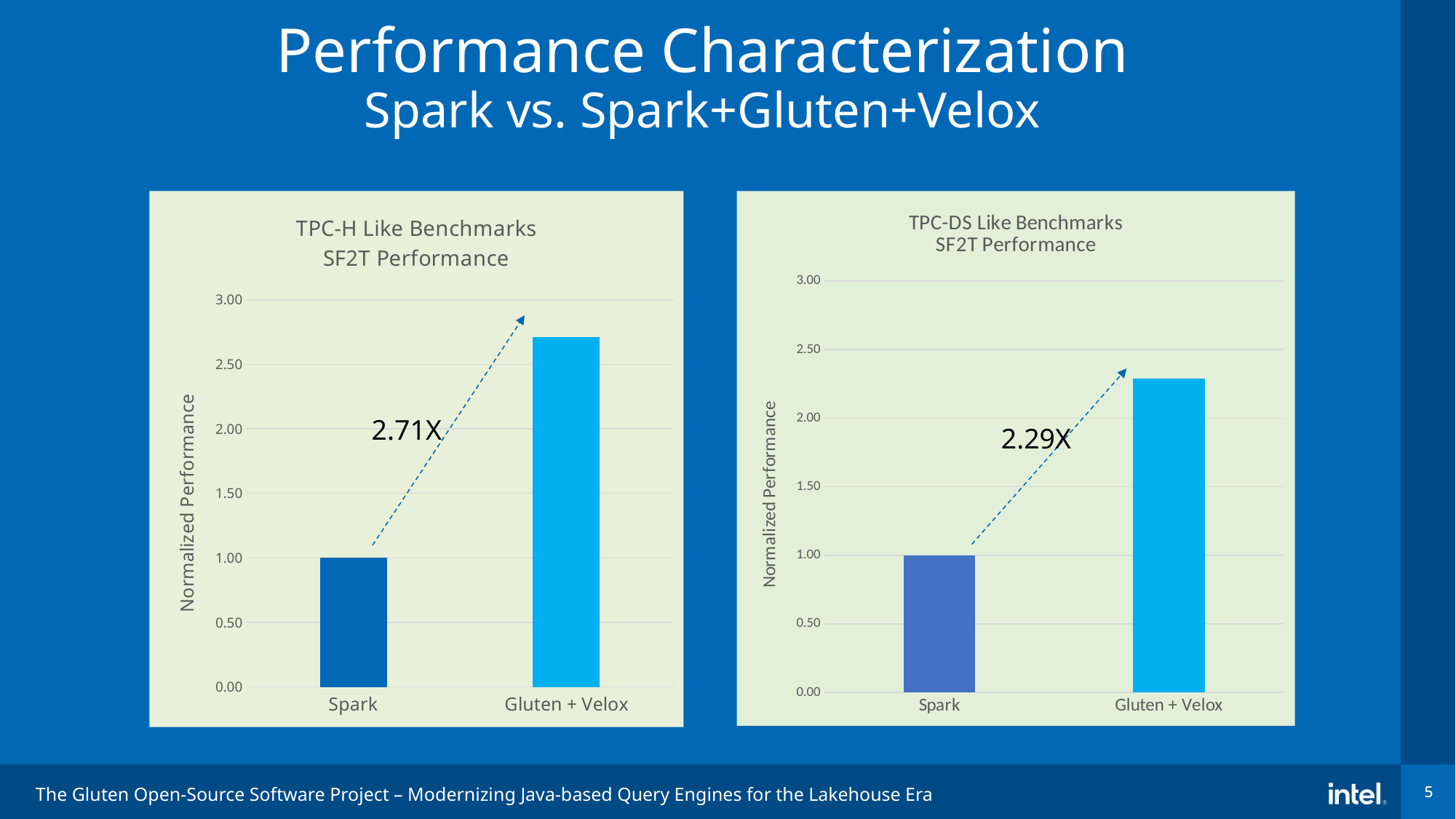
How many categories are shown in the TPC-H Like Benchmarks chart? 2 In the TPC-DS Like Benchmarks chart, is the value for Gluten + Velox greater or less than 2.50? less In the TPC-H Like Benchmarks chart, is the value for Gluten + Velox greater or less than 2.50? greater In the TPC-H Like Benchmarks chart, what is the normalized performance value for Spark? 1.00 In the TPC-DS Like Benchmarks chart, what speedup factor is annotated next to the arrow? 2.29X In the TPC-DS Like Benchmarks chart, what is the normalized performance value for Spark? 1.00 What type of chart is the TPC-DS Like Benchmarks chart? Bar chart In the TPC-H Like Benchmarks chart, which category has the highest normalized performance? Gluten + Velox In the TPC-DS Like Benchmarks chart, which category has the lowest normalized performance? Spark In the TPC-DS Like Benchmarks chart, is the value for Gluten + Velox greater or less than 2.00? greater What is the y-axis label of the TPC-H Like Benchmarks chart? Normalized Performance In the TPC-H Like Benchmarks chart, what speedup factor is annotated next to the arrow? 2.71X